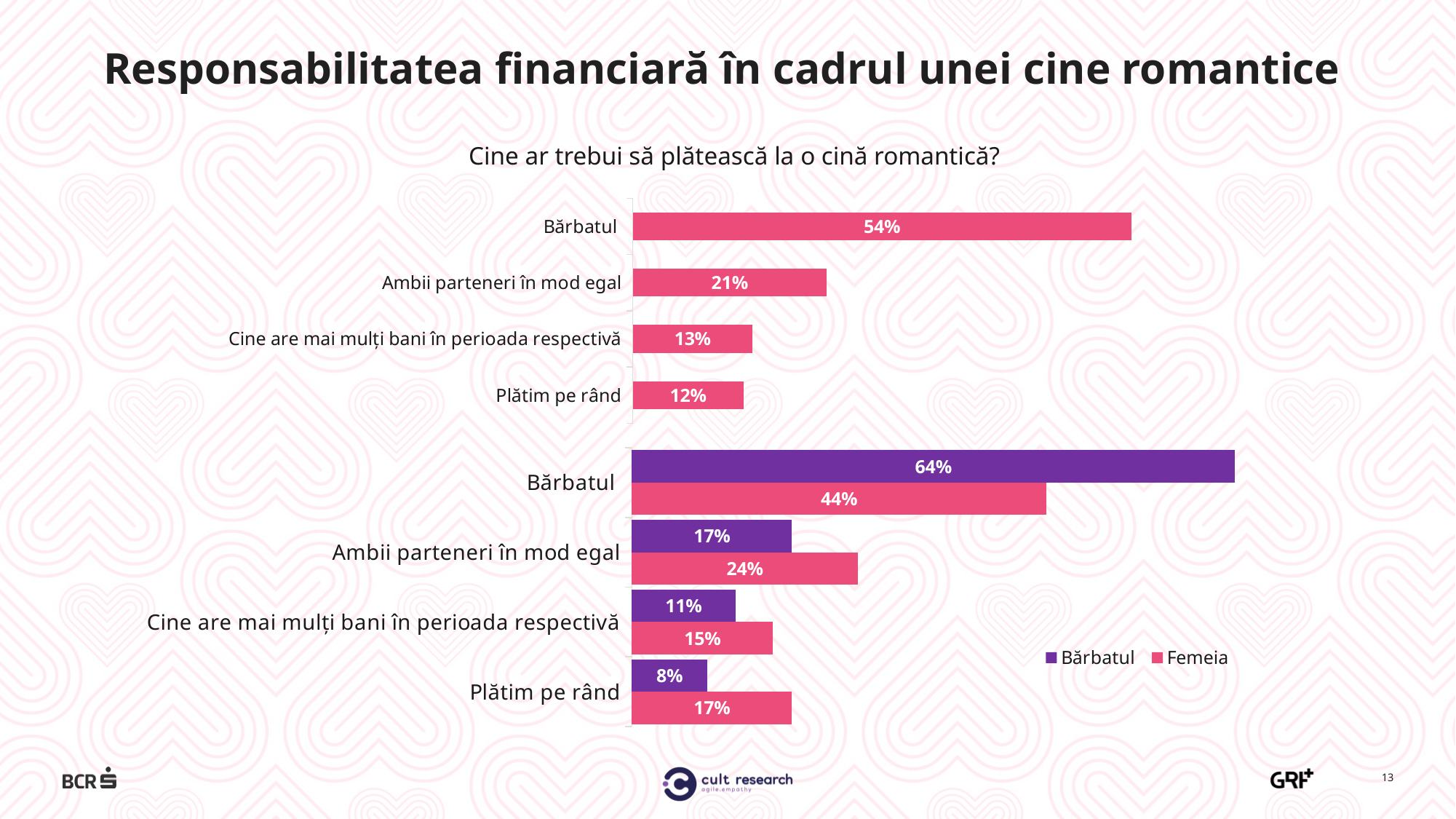
In the bottom chart, what is the Bărbatul value for "Bărbatul"? 64% In the top chart, what is the value for "Plătim pe rând"? 12% What type of chart is the bottom chart? Bar chart In the bottom chart, which is larger for "Plătim pe rând": Bărbatul or Femeia? Femeia How many series does the legend of the bottom chart list? 2 In the top chart, which category has the lowest value? Plătim pe rând In the bottom chart, what is the difference between the Bărbatul and Femeia values for "Bărbatul"? 20% In the top chart, what is the difference between "Bărbatul" and "Ambii parteneri în mod egal"? 33% In the top chart, how many categories are shown? 4 In the bottom chart, what is the Femeia value for "Ambii parteneri în mod egal"? 24% In the top chart, which category has the highest value? Bărbatul In the top chart, what is the value for "Bărbatul"? 54%